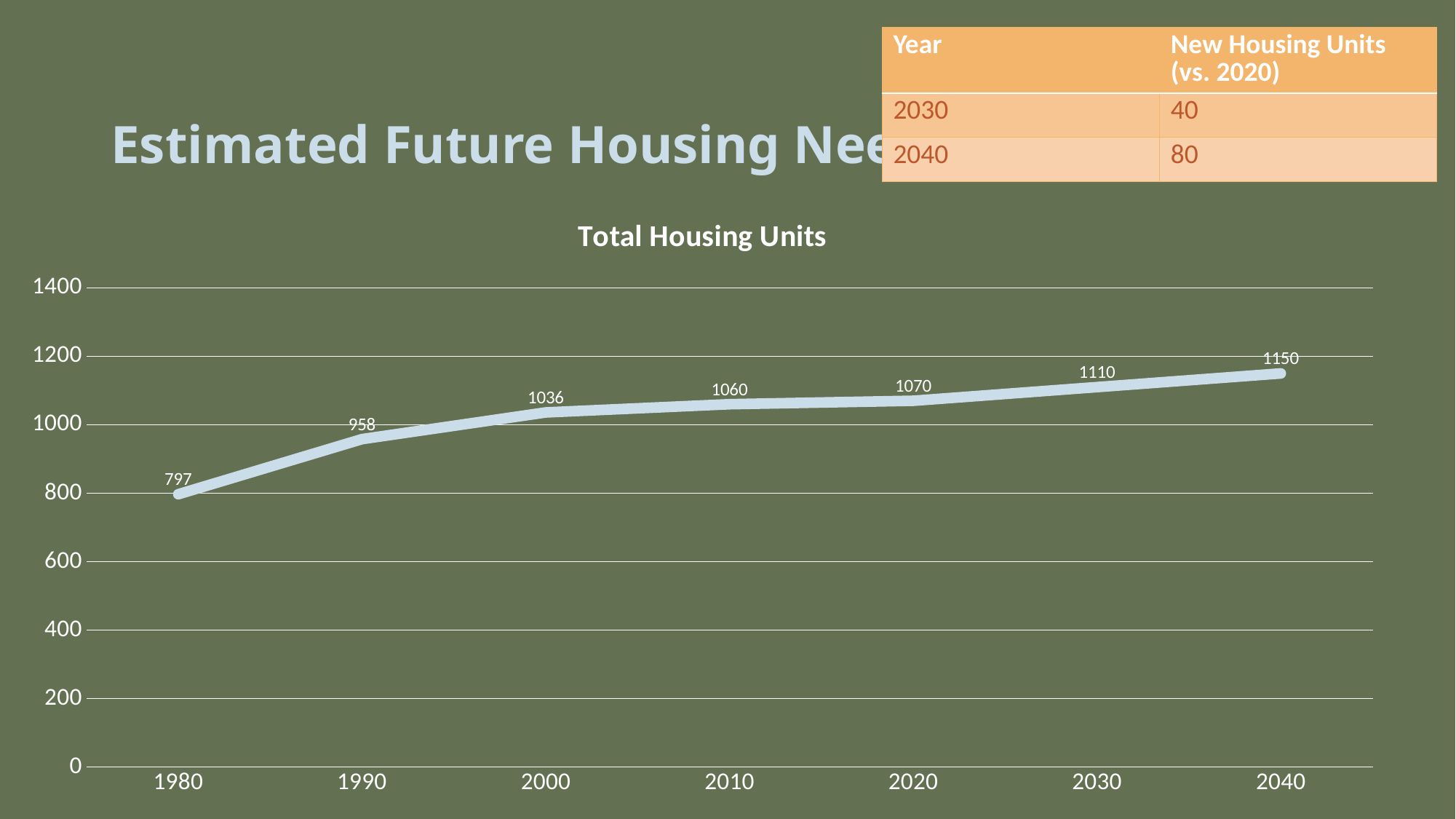
What is the total housing units value for 2000? 1036 What is the difference in total housing units between 2040 and 2020? 80 What is the difference in total housing units between 1990 and 1980? 161 What kind of chart is shown on the slide? line chart What is the total housing units value for 1980? 797 Do total housing units rise or fall from 1980 to 2040? rise Which year has more total housing units, 2010 or 1990? 2010 What is the total housing units value for 2040? 1150 How many years are plotted on the chart? 7 Which year has the lowest total housing units? 1980 Which year has the highest total housing units? 2040 Is the value for 1980 greater or less than 1000? less